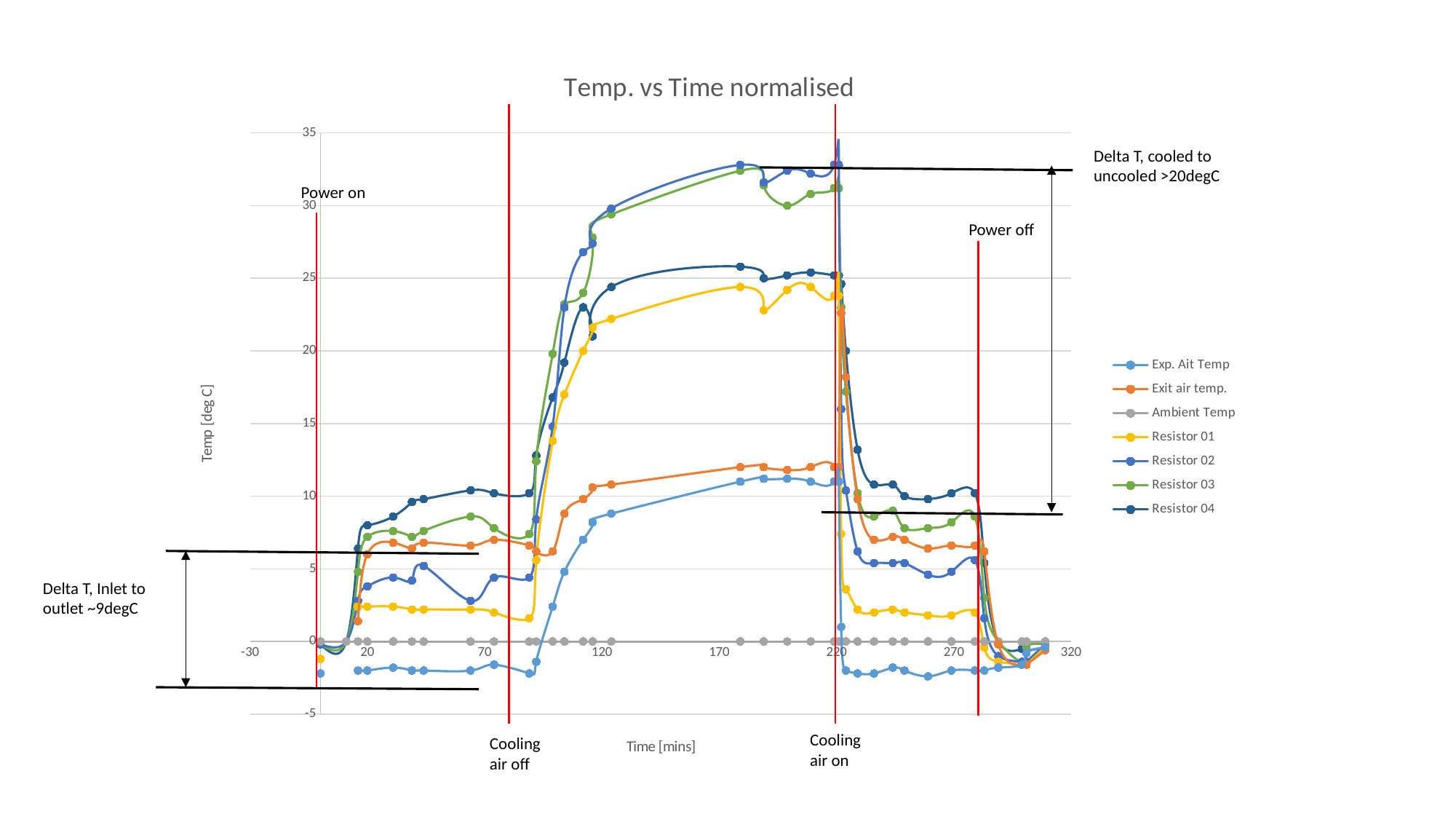
Is the value for Exp. Ait Temp at around 50 mins greater or less than 0? less What kind of chart is shown on the slide? line chart What is the title of the chart? Temp. vs Time normalised Which series reaches the highest value anywhere on the chart? Resistor 02 Between about 100 and 170 mins, does the value for Resistor 03 rise or fall? rise Is the value for Resistor 04 at around 50 mins greater or less than 5? greater Is the peak value of Resistor 02 greater or less than 30? greater What is the label on the vertical axis? Temp [deg C] How many series does the legend list? 7 Between 120 and 220 mins, which series is higher: Exit air temp. or Exp. Ait Temp? Exit air temp.